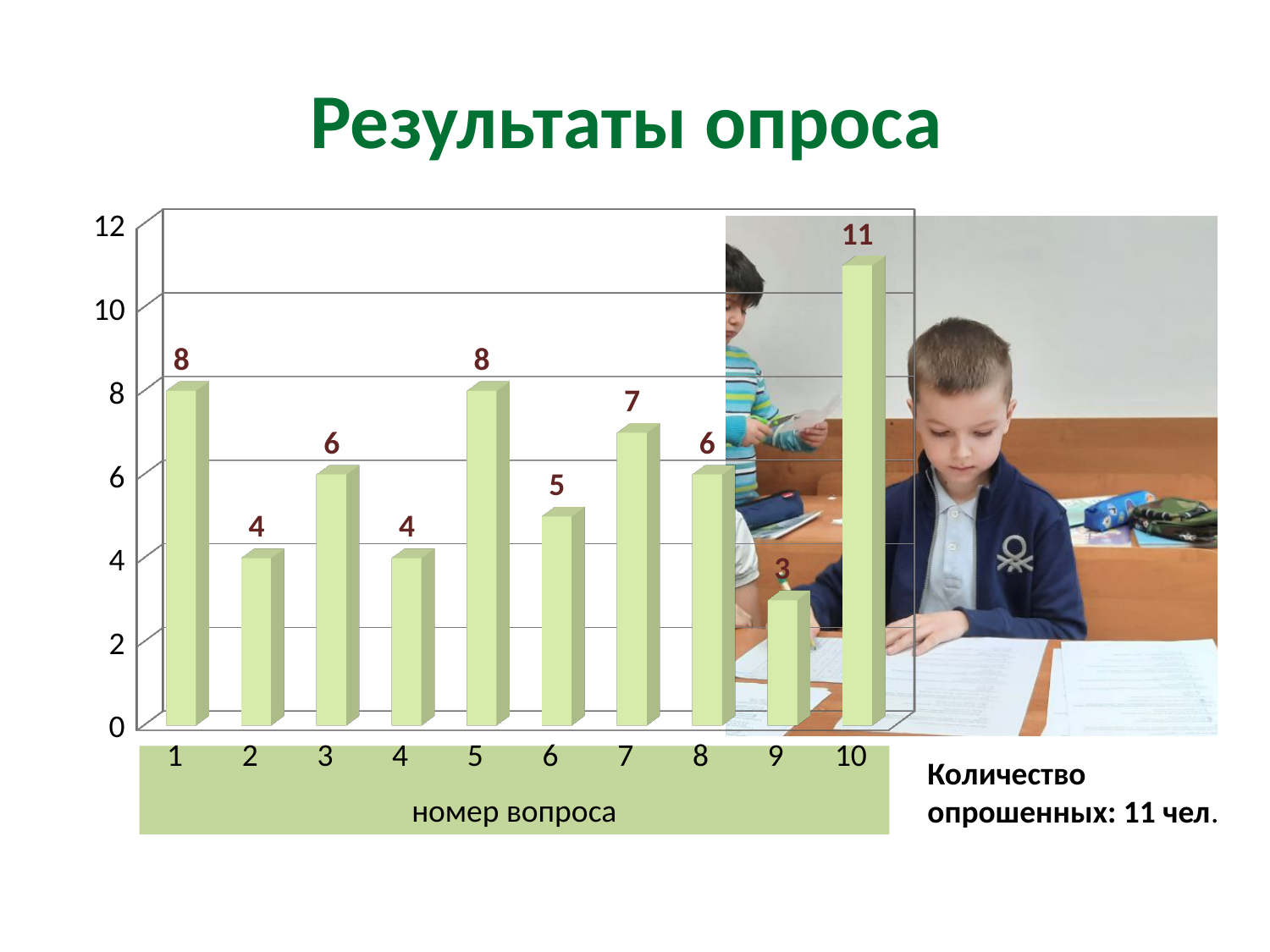
What is the difference between the values for question 10 and question 9? 8 Which question number has the highest value? 10 What is the value for question number 10? 11 Which has a larger value, question 3 or question 6? question 3 What kind of chart is shown on the slide? bar chart What is the value for question number 7? 7 What is the label of the x axis? номер вопроса How many question numbers are shown on the x axis? 10 What is the value for question number 9? 3 Is the value for question 5 greater or less than 6? greater Which question number has the lowest value? 9 What is the title of the slide? Результаты опроса